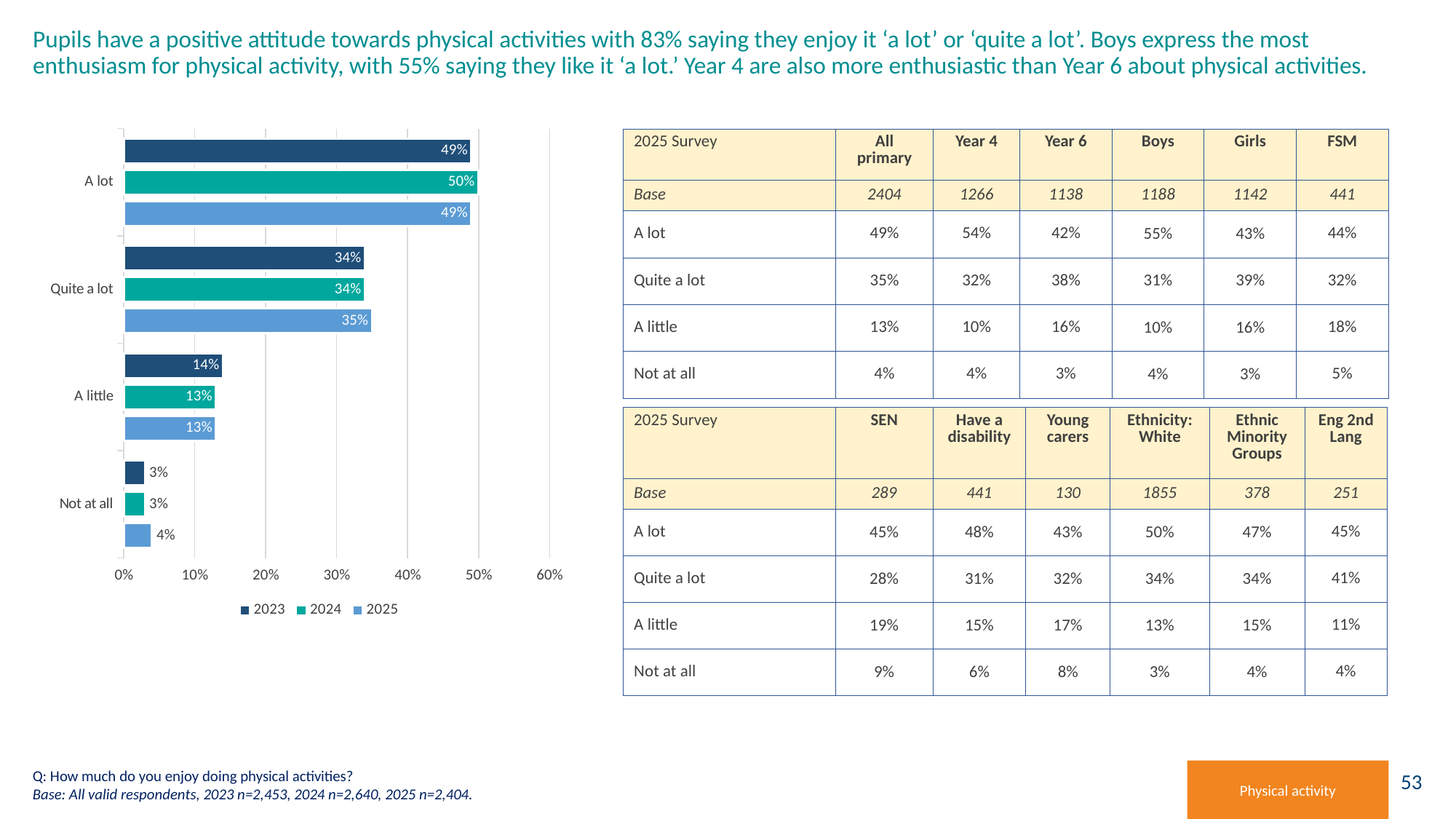
Is the 2024 value for 'A lot' greater or less than 40%? greater What type of chart is shown on the slide? Bar chart Which year has the larger value for 'A little', 2023 or 2025? 2023 What percentage of pupils said they enjoy physical activities 'A lot' in 2024? 50% Which response category has the highest value for 2025? A lot Which response category has the lowest value for 2023? Not at all How many response categories are shown on the chart? 4 What percentage of pupils said 'Not at all' in 2025? 4% What is the 2023 value for 'A little'? 14% What is the 2025 value for 'Quite a lot'? 35% How many series does the chart's legend list? 3 What is the difference between the 2025 values for 'A lot' and 'Quite a lot'? 14 percentage points